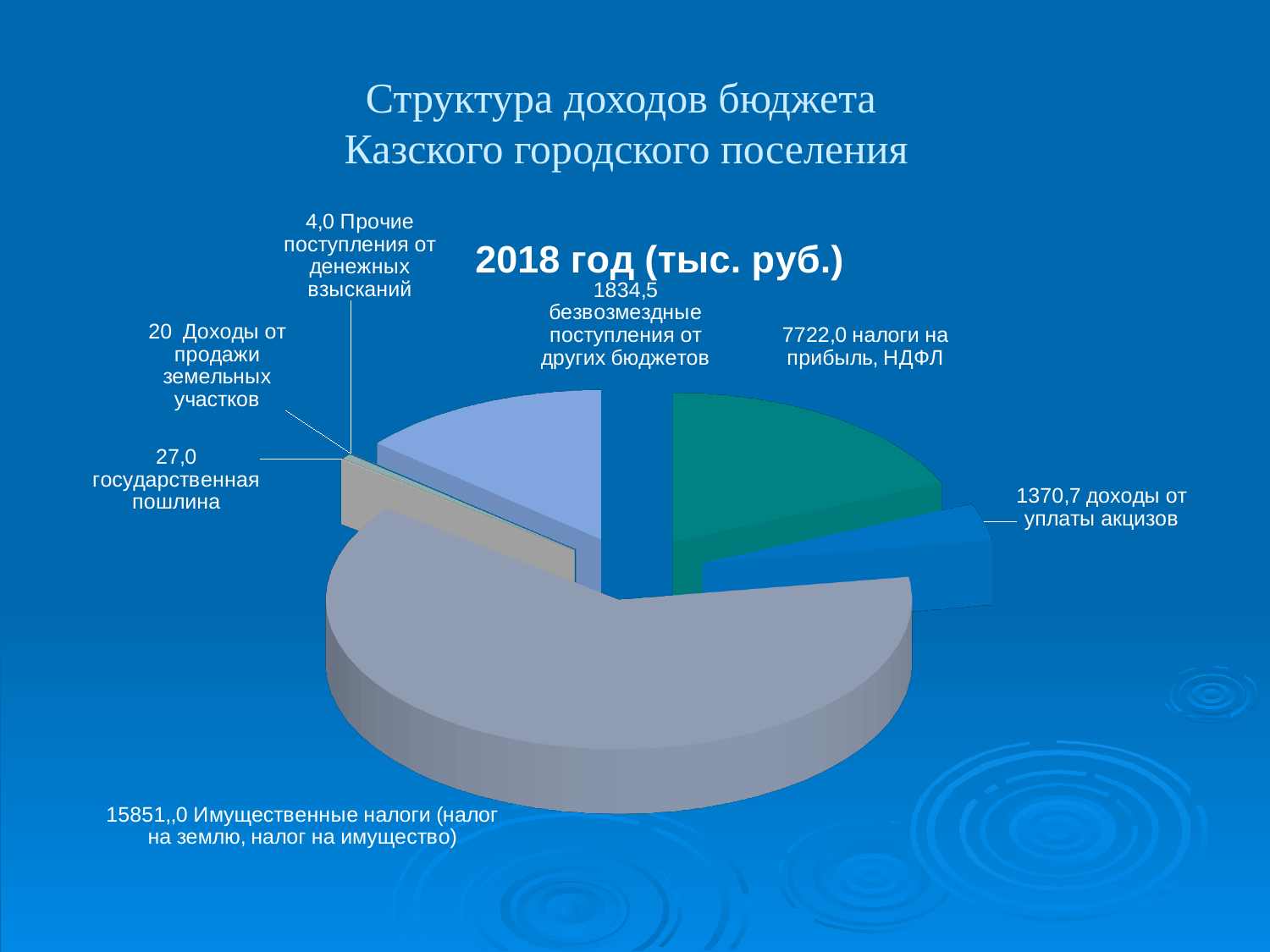
What is the difference between налоги на прибыль, НДФЛ and доходы от уплаты акцизов? 6351,3 What is the value for безвозмездные поступления от других бюджетов? 1834,5 Which is larger: безвозмездные поступления от других бюджетов or доходы от уплаты акцизов? безвозмездные поступления от других бюджетов What is the difference between государственная пошлина and Доходы от продажи земельных участков? 7,0 What is the value for доходы от уплаты акцизов? 1370,7 What is the value for государственная пошлина? 27,0 What is the title of the pie chart? 2018 год (тыс. руб.) How many slices does the pie chart have? 7 What kind of chart is shown on the slide? Pie chart What is the value for налоги на прибыль, НДФЛ? 7722,0 Which category has the largest slice of the pie? Имущественные налоги (налог на землю, налог на имущество) Which category has the smallest value in the pie chart? Прочие поступления от денежных взысканий